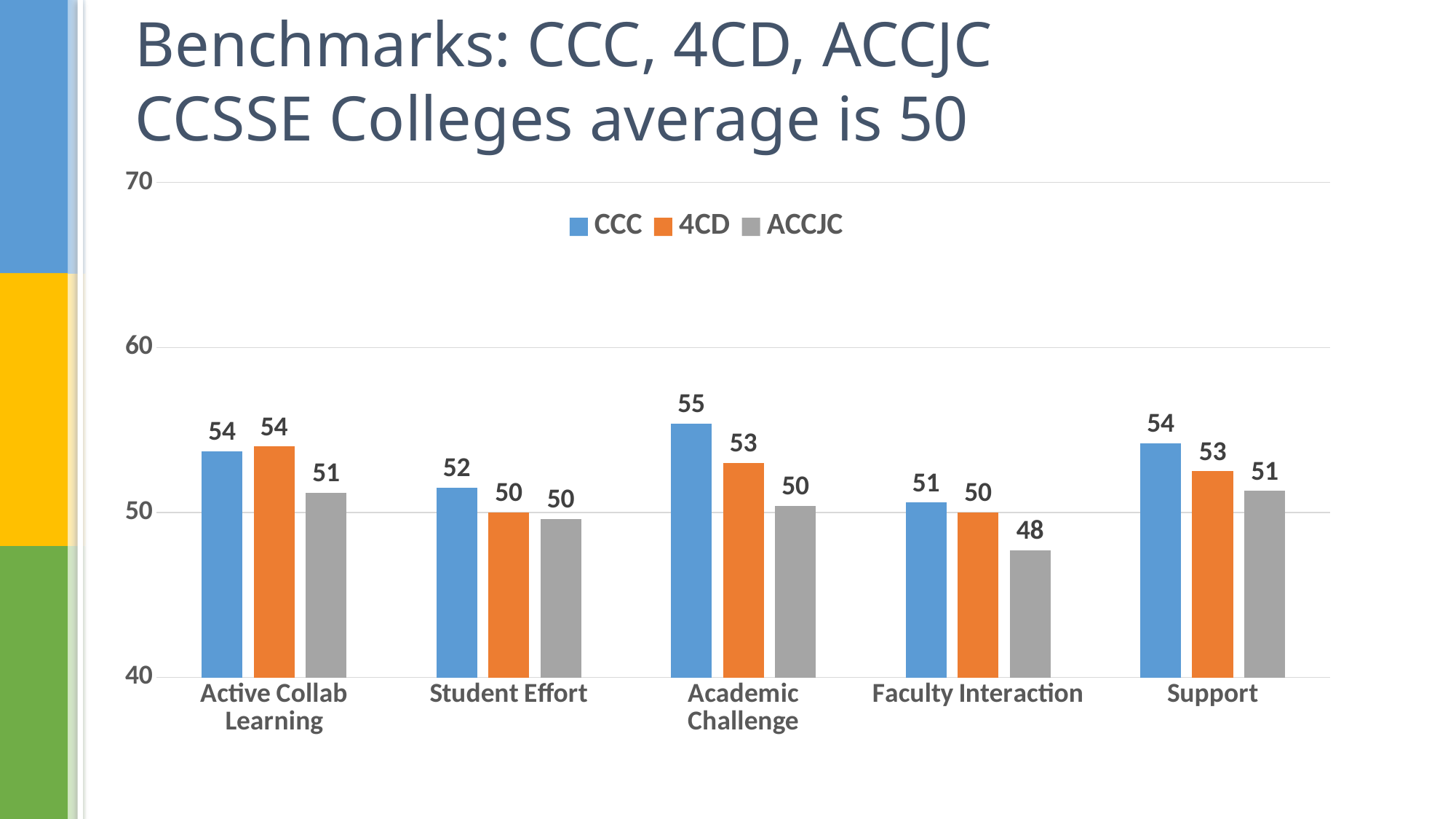
How many categories are shown on the x axis? 5 What is the difference between the CCC and ACCJC values for Academic Challenge? 5 Is the ACCJC value for Faculty Interaction greater or less than 50? less What is the 4CD value for Support? 53 Which category has the lowest ACCJC value? Faculty Interaction What kind of chart is shown on the slide? bar chart How many series does the legend list? 3 Which category has the highest CCC value? Academic Challenge Which is larger for Support: the CCC value or the ACCJC value? CCC Which series is shown in orange in the legend? 4CD What is the ACCJC value for Faculty Interaction? 48 What is the CCC value for Academic Challenge? 55